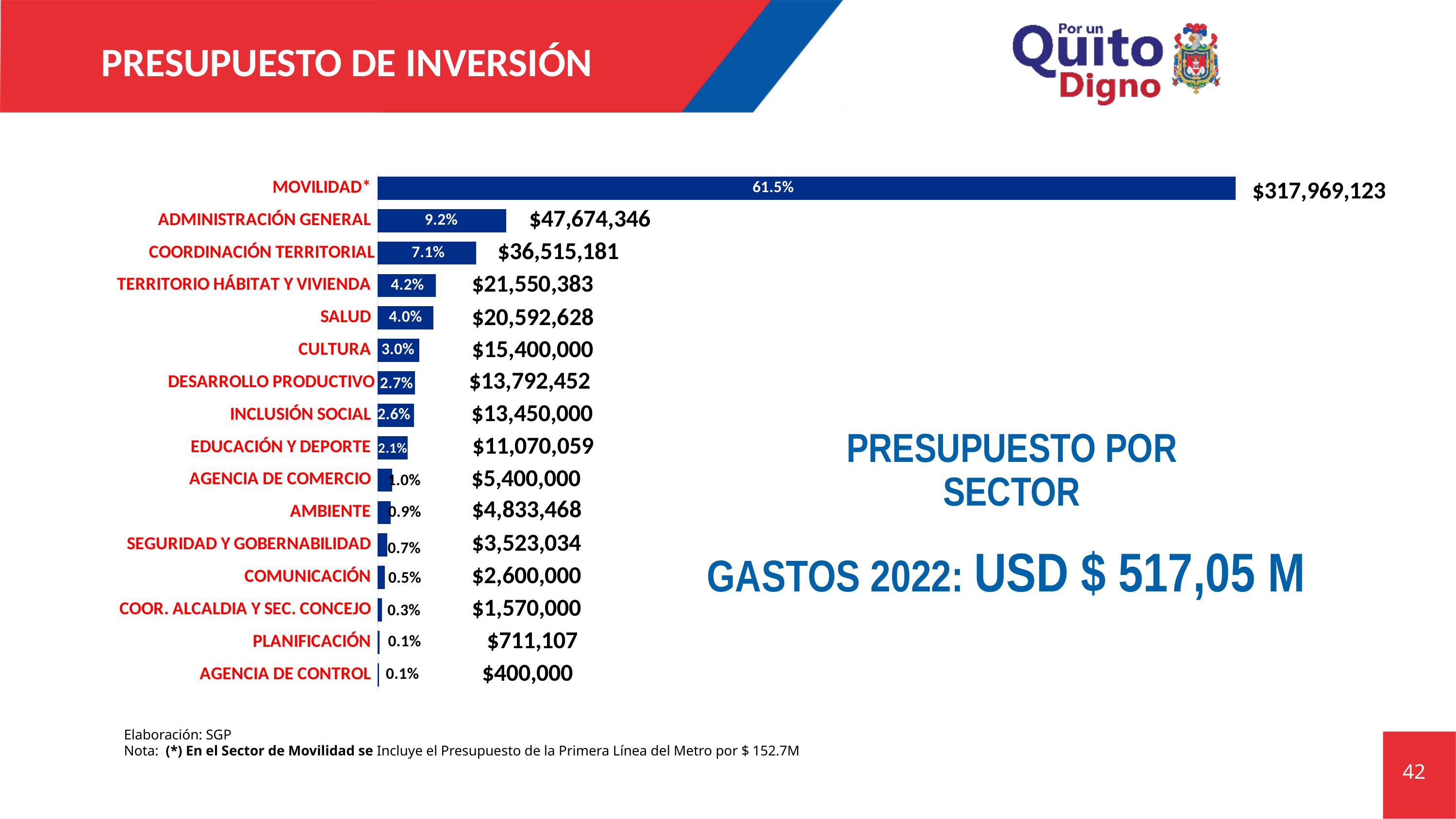
Which sector has the lowest dollar amount in the chart? AGENCIA DE CONTROL Which sector has the highest budget in the chart? MOVILIDAD* What percentage is shown for EDUCACIÓN Y DEPORTE? 2.1% Which has a larger budget, AMBIENTE or AGENCIA DE COMERCIO? AGENCIA DE COMERCIO How many sectors are shown in the chart? 16 What is the difference in dollar amount between CULTURA and INCLUSIÓN SOCIAL? $1,950,000 What percentage is shown for MOVILIDAD* in the chart? 61.5% What is the difference in percentage points between ADMINISTRACIÓN GENERAL and COORDINACIÓN TERRITORIAL? 2.1 What is the dollar amount shown for SALUD? $20,592,628 What is the dollar amount shown for COORDINACIÓN TERRITORIAL? $36,515,181 What total for GASTOS 2022 is stated on the slide? USD $ 517,05 M What type of chart is shown on the slide? Bar chart